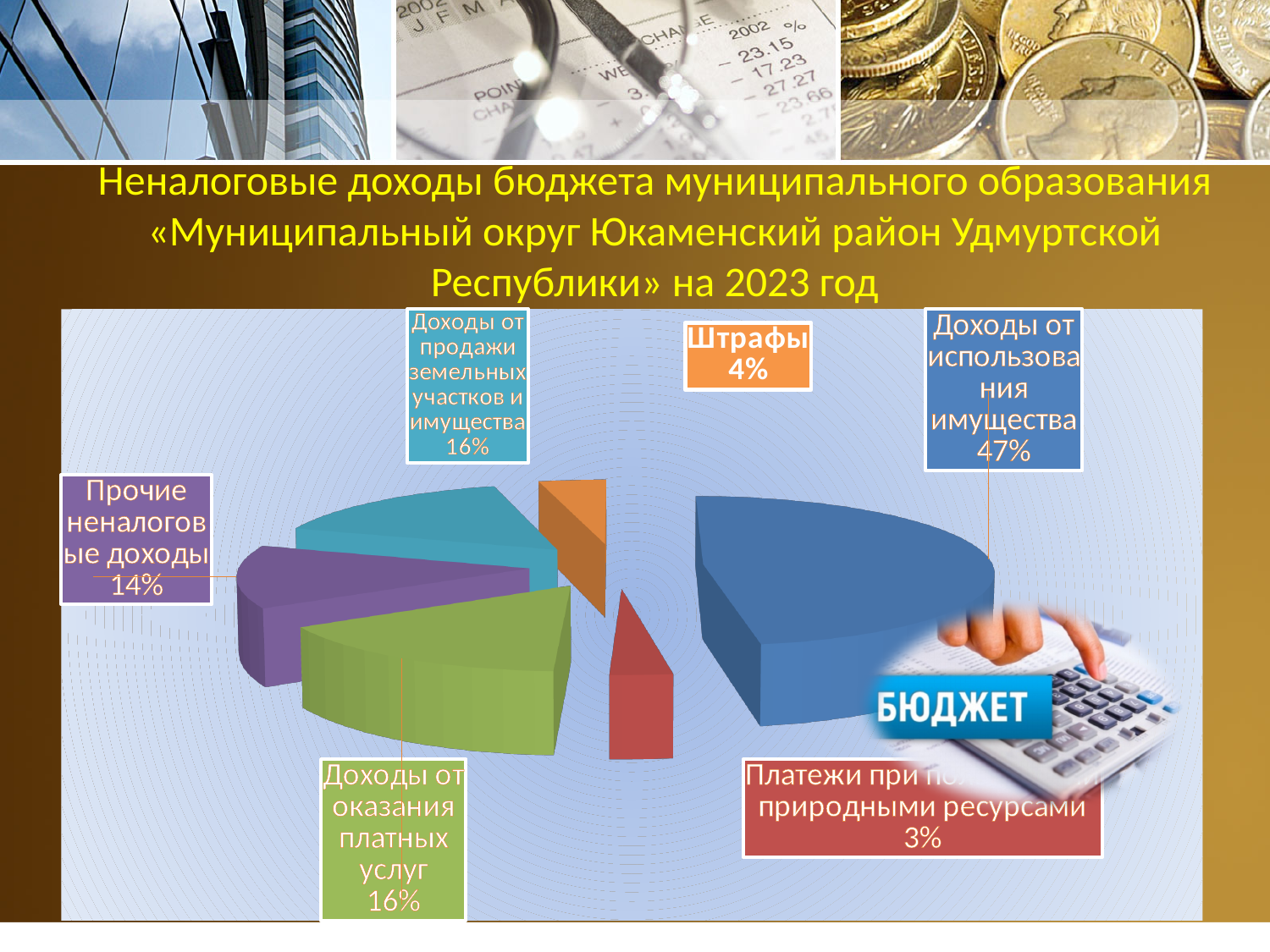
How many slices does the pie chart have? 6 Which is larger: the share for «Штрафы» or the share for «Платежи при пользовании природными ресурсами»? Штрафы What share of the pie does «Доходы от использования имущества» have? 47% What colour is the slice for «Доходы от использования имущества»? Blue Which category has the largest share of the pie? Доходы от использования имущества What share of the pie does «Прочие неналоговые доходы» have? 14% Which category has the smallest share of the pie? Платежи при пользовании природными ресурсами What kind of chart is shown on the slide? Pie chart What share of the pie does «Штрафы» have? 4% What share of the pie does «Платежи при пользовании природными ресурсами» have? 3% What is the difference in percentage points between «Доходы от использования имущества» and «Прочие неналоговые доходы»? 33 percentage points What share of the pie does «Доходы от оказания платных услуг» have? 16%